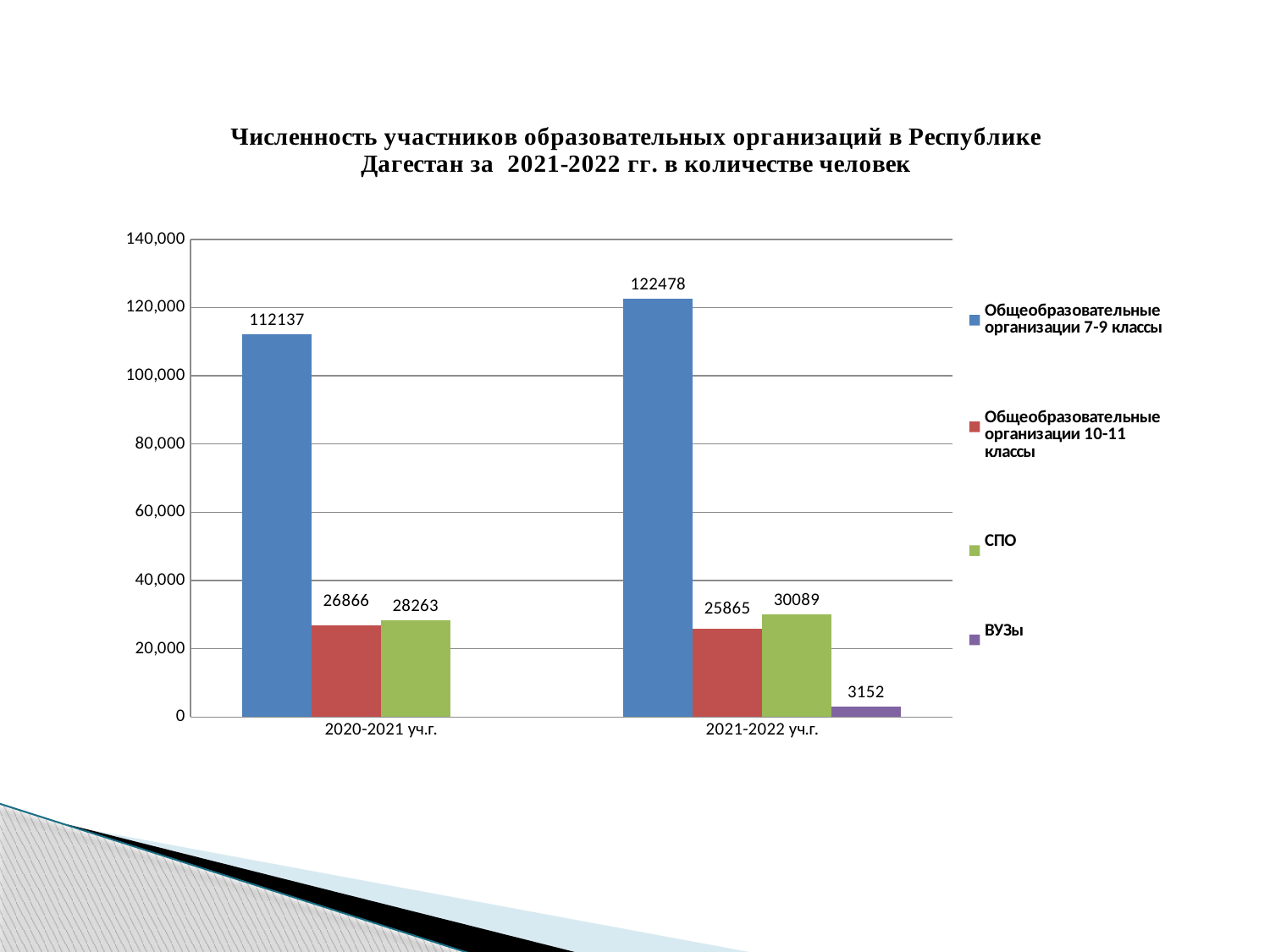
Which series has the lowest value in 2021-2022 уч.г.? ВУЗы Which series has the highest value in 2021-2022 уч.г.? Общеобразовательные организации 7-9 классы How many series does the legend list? 4 Which is larger: Общеобразовательные организации 10-11 классы in 2020-2021 уч.г. or in 2021-2022 уч.г.? 2020-2021 уч.г. What is the difference between the values for Общеобразовательные организации 7-9 классы in 2021-2022 уч.г. and 2020-2021 уч.г.? 10341 What is the value for ВУЗы in 2021-2022 уч.г.? 3152 What is the value for Общеобразовательные организации 7-9 классы in 2021-2022 уч.г.? 122478 What is the value for Общеобразовательные организации 7-9 классы in 2020-2021 уч.г.? 112137 Does the value for СПО rise or fall from 2020-2021 уч.г. to 2021-2022 уч.г.? rise How many categories are shown on the x axis? 2 What is the value for СПО in 2021-2022 уч.г.? 30089 What kind of chart is shown on the slide? bar chart